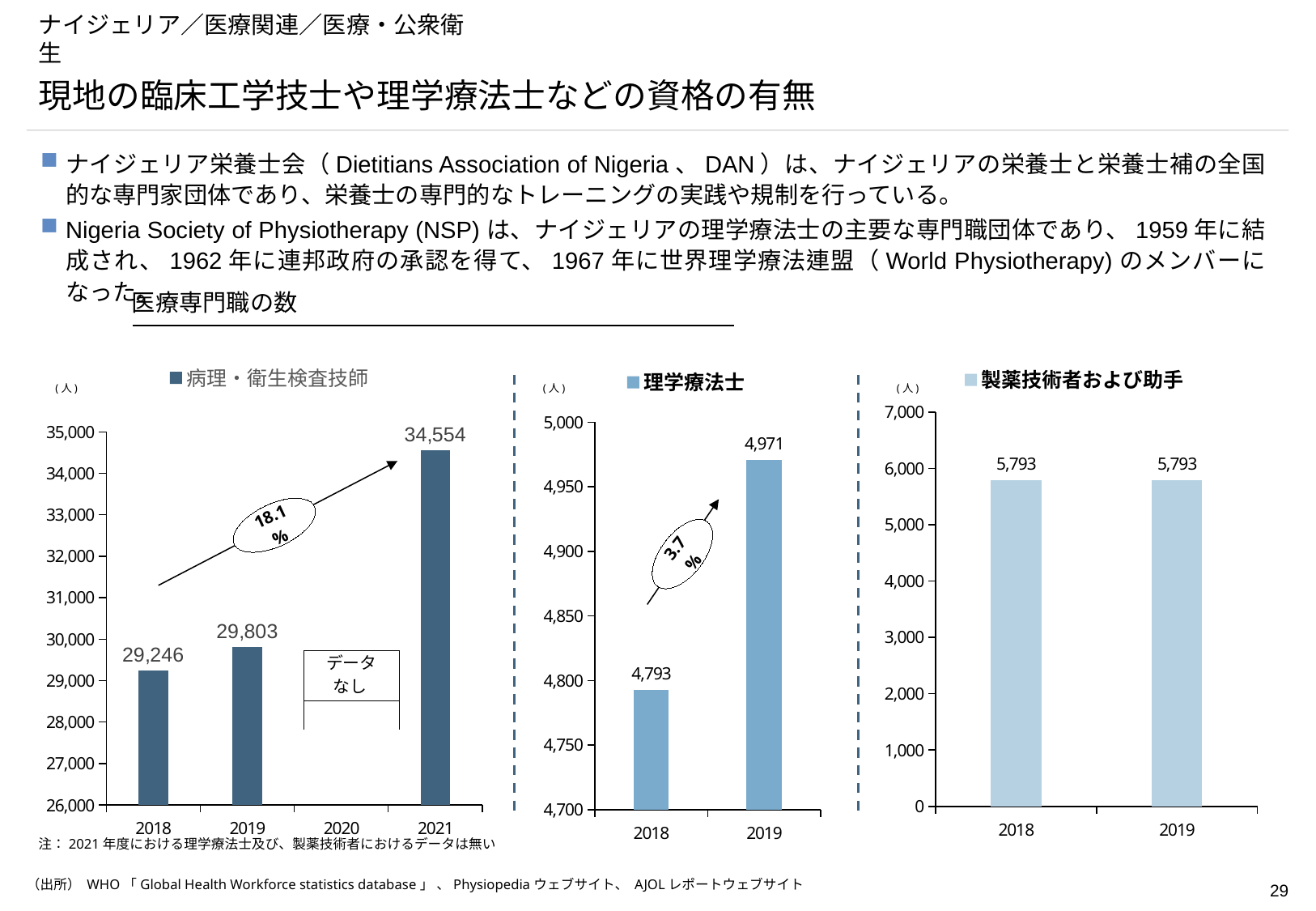
In the 病理・衛生検査技師 chart, what is the difference between the 2019 and 2018 values? 557 In the 病理・衛生検査技師 chart, which year has the highest value? 2021 In the 理学療法士 chart, what is the difference between the 2019 and 2018 values? 178 In the 病理・衛生検査技師 chart, what is the value for 2021? 34,554 In the 病理・衛生検査技師 chart, what is the value for 2018? 29,246 What type of chart is the 製薬技術者および助手 chart? bar chart In the 理学療法士 chart, what is the value for 2019? 4,971 In the 病理・衛生検査技師 chart, what is shown for 2020? データなし In the 製薬技術者および助手 chart, do the values rise, fall, or stay the same from 2018 to 2019? stay the same In the 製薬技術者および助手 chart, what is the value for 2018? 5,793 In the 理学療法士 chart, what growth percentage is annotated between 2018 and 2019? 3.7% How many years are shown on the x axis of the 理学療法士 chart? 2